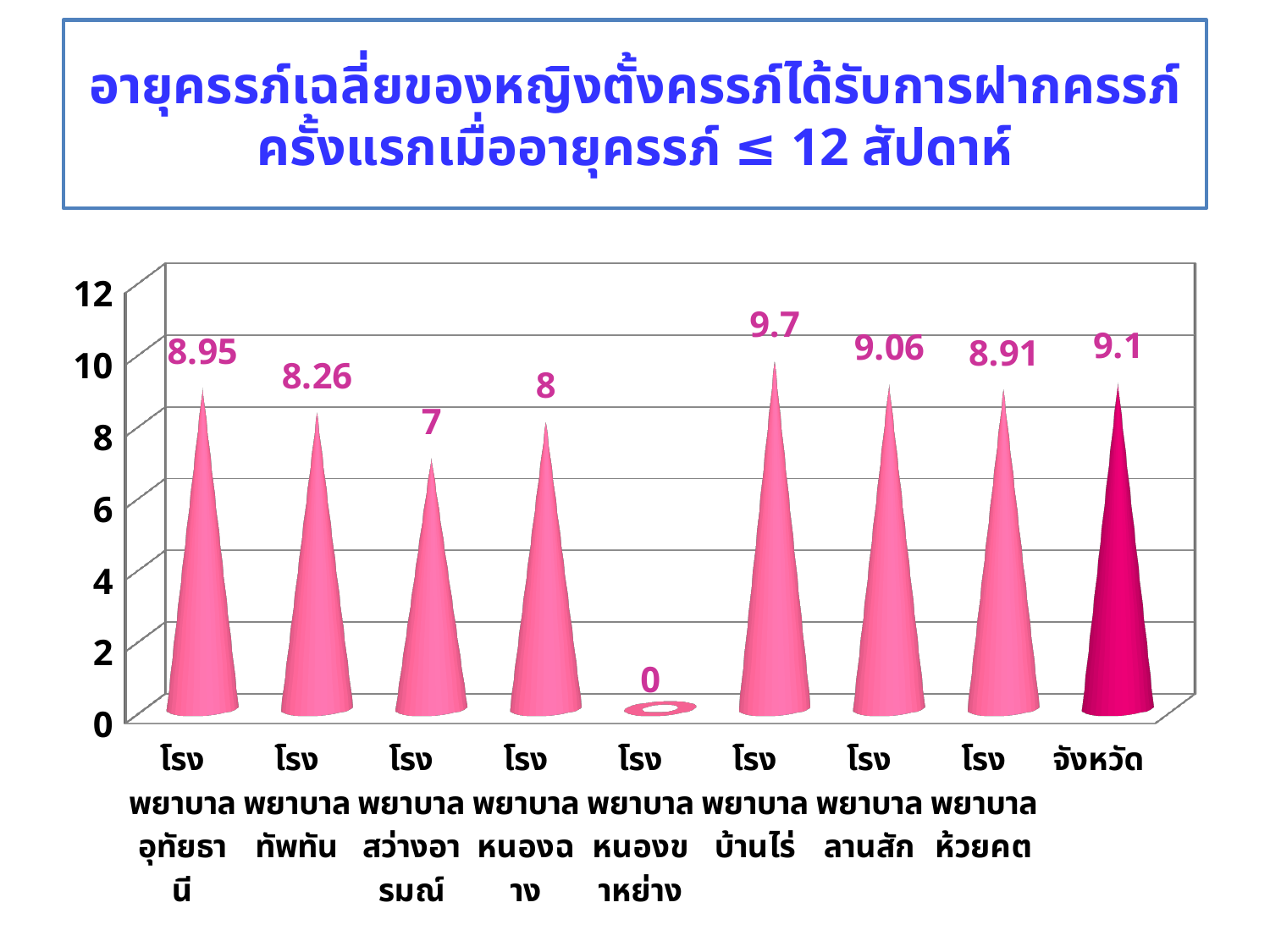
What is the value for จังหวัด? 9.1 Which category has the lowest value? โรงพยาบาลหนองขาหย่าง Which is larger, the value for โรงพยาบาลทัพทัน or โรงพยาบาลหนองฉาง? โรงพยาบาลทัพทัน What kind of chart is shown on the slide? bar chart What is the difference between the values for โรงพยาบาลบ้านไร่ and โรงพยาบาลสว่างอารมณ์? 2.7 What is the maximum value shown on the y axis? 12 What is the value for โรงพยาบาลบ้านไร่? 9.7 Is the value for โรงพยาบาลลานสัก greater or less than 8? greater What is the value for โรงพยาบาลหนองขาหย่าง? 0 What is the value for โรงพยาบาลอุทัยธานี? 8.95 Which category has the highest value? โรงพยาบาลบ้านไร่ How many categories are shown on the x axis? 9